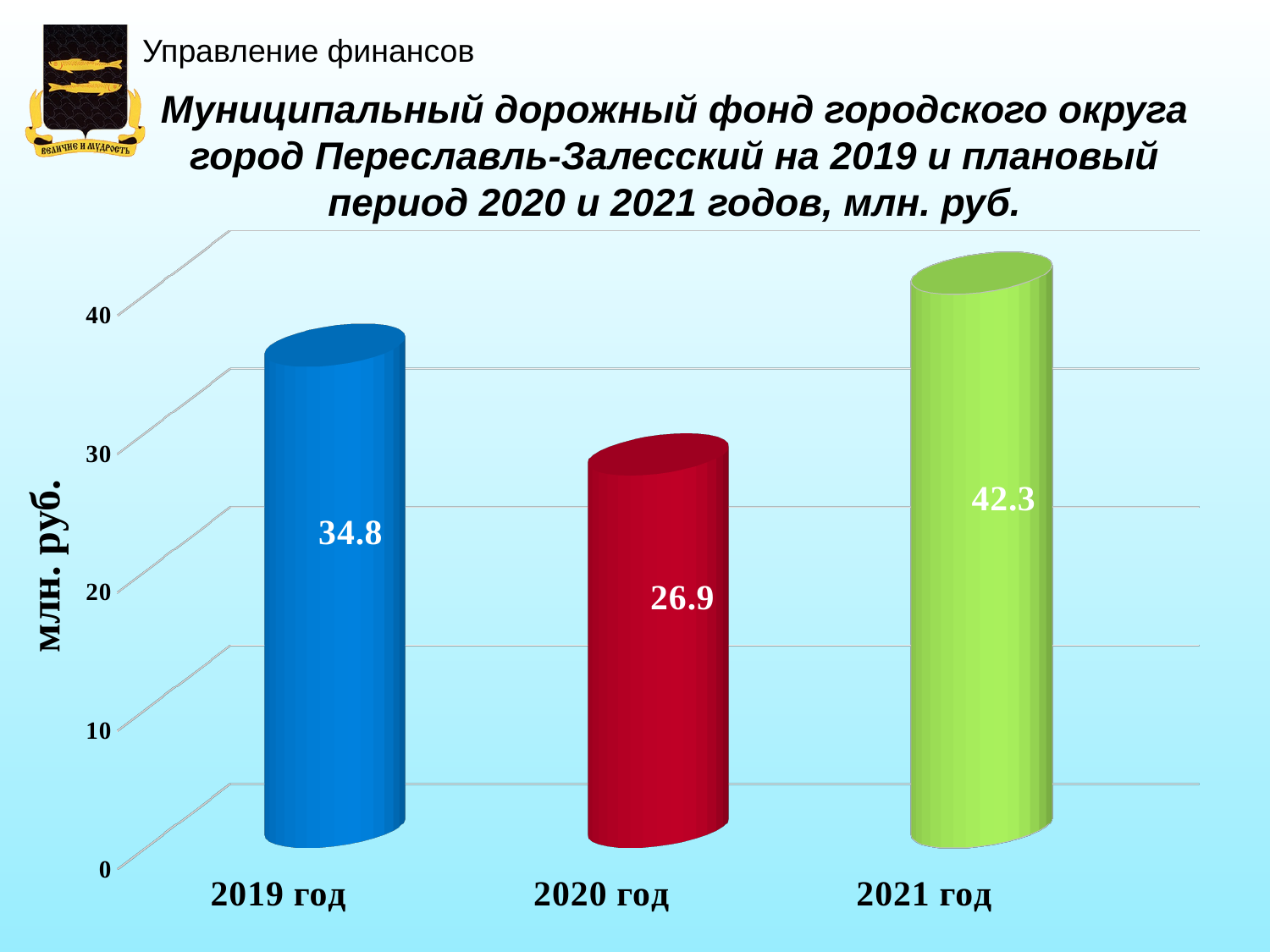
What kind of chart is shown on the slide? bar chart What is the value for 2020 год? 26.9 What is the label of the vertical axis? млн. руб. How many categories are shown on the x axis? 3 Which year has the highest value? 2021 год Which year has the lowest value? 2020 год What is the difference between the values for 2019 год and 2020 год? 7.9 Which is larger, the value for 2019 год or the value for 2021 год? 2021 год What is the value for 2019 год? 34.8 Is the value for 2020 год greater or less than 30? less What is the value for 2021 год? 42.3 What is the difference between the values for 2021 год and 2020 год? 15.4